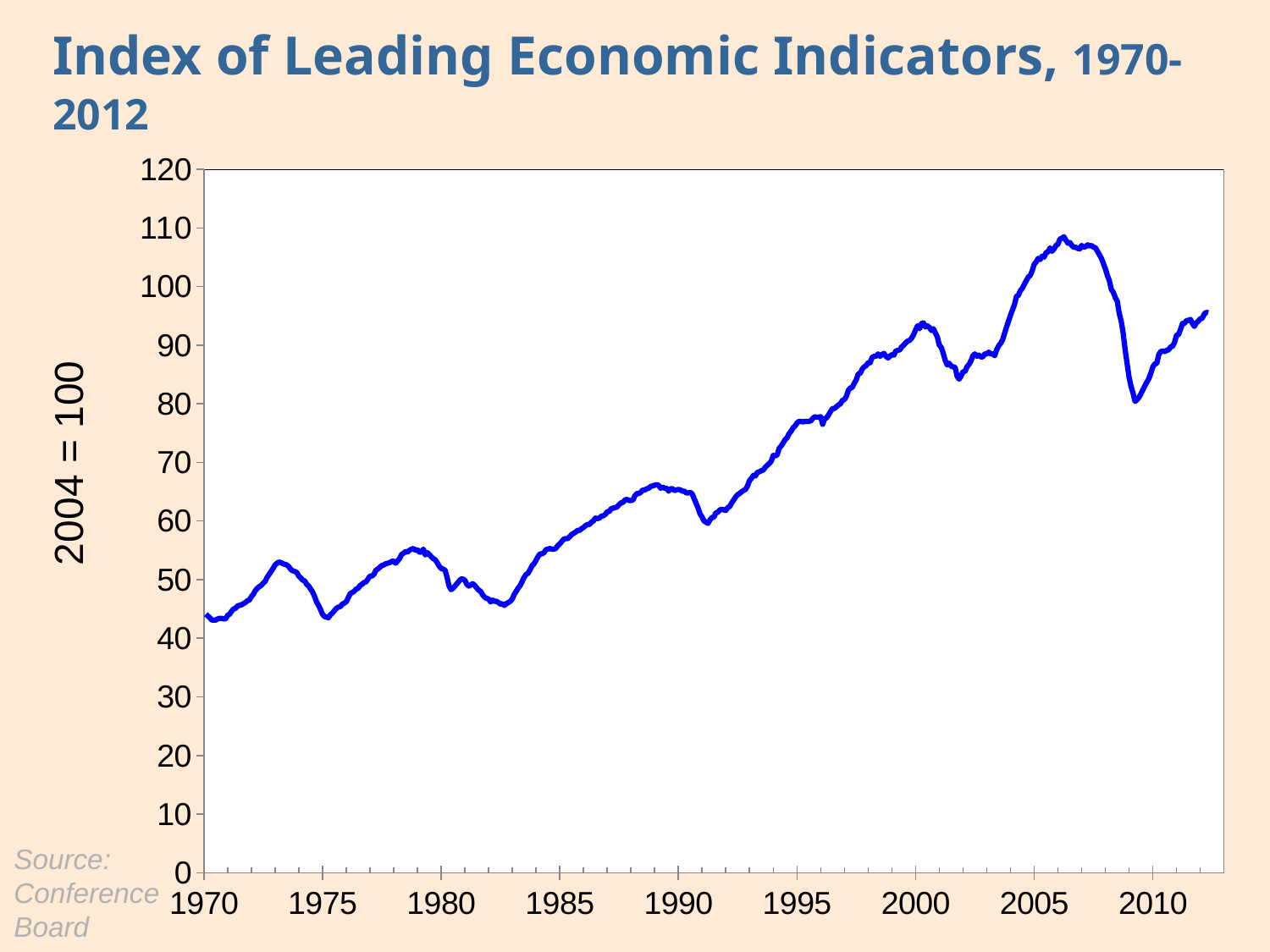
What is the title of the chart? Index of Leading Economic Indicators, 1970-2012 Is the value of the index in 1970 greater or less than 50? less Which is larger, the index value in 2005 or in 1985? 2005 Around which year does the index reach its highest point? 2006 What is the label on the vertical axis? 2004 = 100 Overall, does the index rise or fall from 1970 to 2012? rise Is the peak value of the index around 2006 greater or less than 100? greater Is the value of the index in 2010 greater or less than 80? greater What kind of chart is shown on the slide? line chart